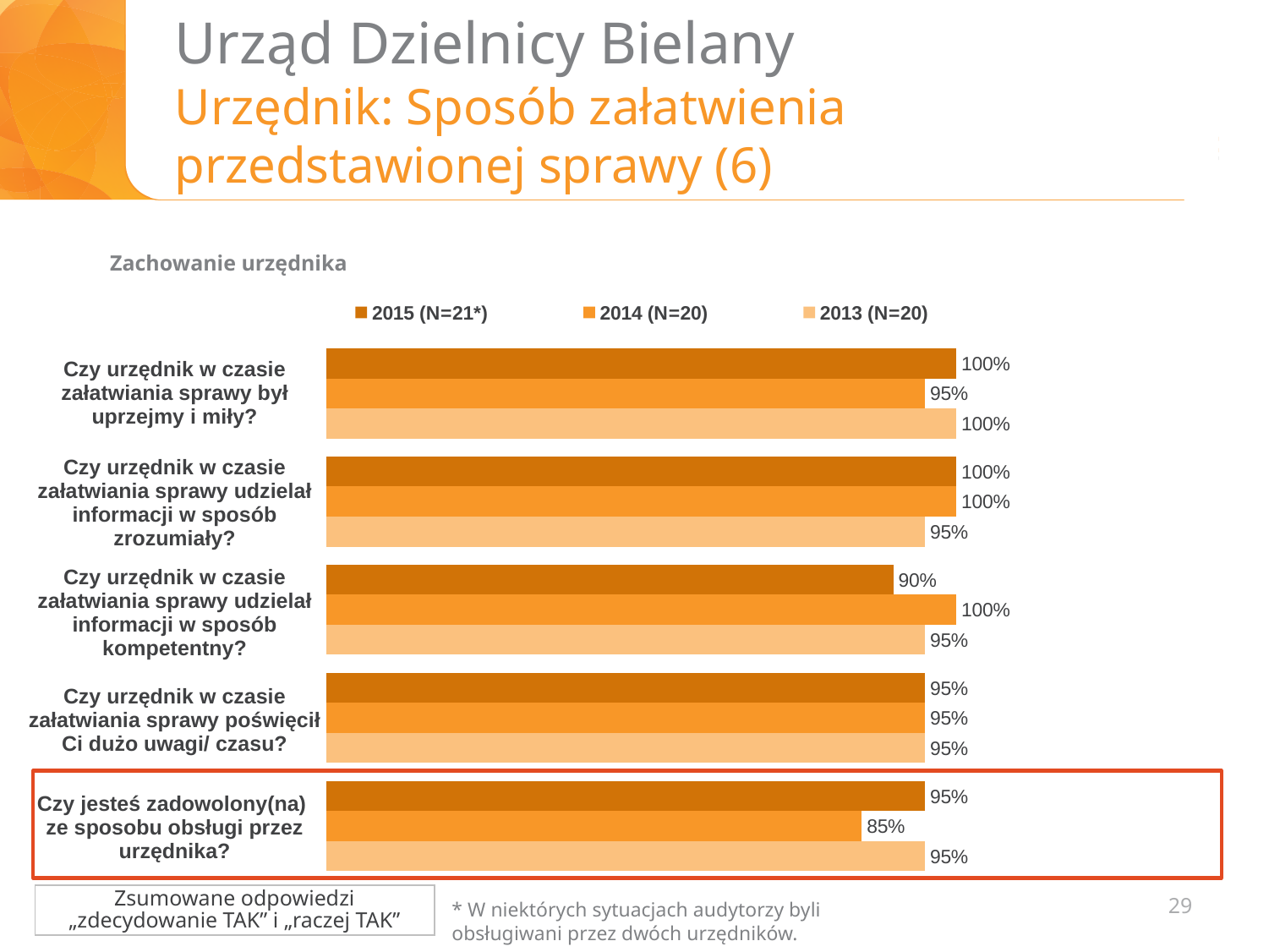
What is the 2014 (N=20) value for "Czy jesteś zadowolony(na) ze sposobu obsługi przez urzędnika?"? 85% Which category has the lowest 2014 (N=20) value? Czy jesteś zadowolony(na) ze sposobu obsługi przez urzędnika? What is the 2014 (N=20) value for "Czy urzędnik w czasie załatwiania sprawy był uprzejmy i miły?"? 95% What is the 2013 (N=20) value for "Czy urzędnik w czasie załatwiania sprawy udzielał informacji w sposób zrozumiały?"? 95% What is the difference between the 2015 (N=21*) and 2014 (N=20) values for "Czy jesteś zadowolony(na) ze sposobu obsługi przez urzędnika?"? 10% Which category has the lowest 2015 (N=21*) value? Czy urzędnik w czasie załatwiania sprawy udzielał informacji w sposób kompetentny? How many series does the chart legend list? 3 What is the 2015 (N=21*) value for "Czy urzędnik w czasie załatwiania sprawy udzielał informacji w sposób kompetentny?"? 90% How many question categories are plotted in the chart? 5 What type of chart is shown on the slide? bar chart What is the title of the chart? Zachowanie urzędnika For "Czy urzędnik w czasie załatwiania sprawy udzielał informacji w sposób kompetentny?", which is larger: the 2015 (N=21*) value or the 2014 (N=20) value? 2014 (N=20)